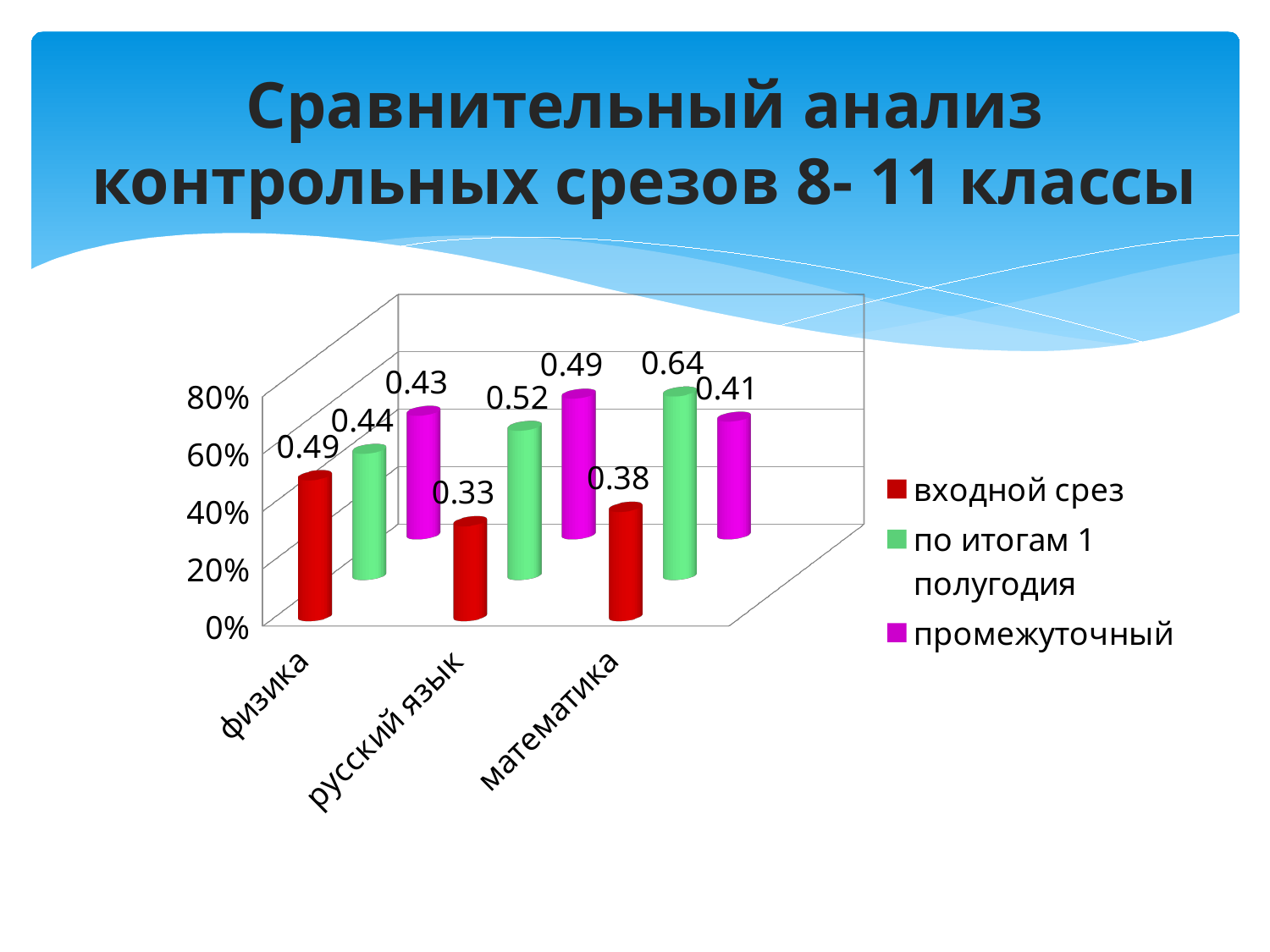
What is the value of входной срез for русский язык? 0.33 What is the difference between the по итогам 1 полугодия and входной срез values for математика? 0.26 What is the value of по итогам 1 полугодия for математика? 0.64 What colour represents the промежуточный series? magenta What is the value of промежуточный for русский язык? 0.49 What kind of chart is shown on the slide? bar chart Which is larger for физика: входной срез or промежуточный? входной срез What is the value of входной срез for физика? 0.49 How many series does the legend list? 3 How many subjects are shown on the x axis? 3 Which subject has the highest value for по итогам 1 полугодия? математика Which subject has the lowest value for входной срез? русский язык